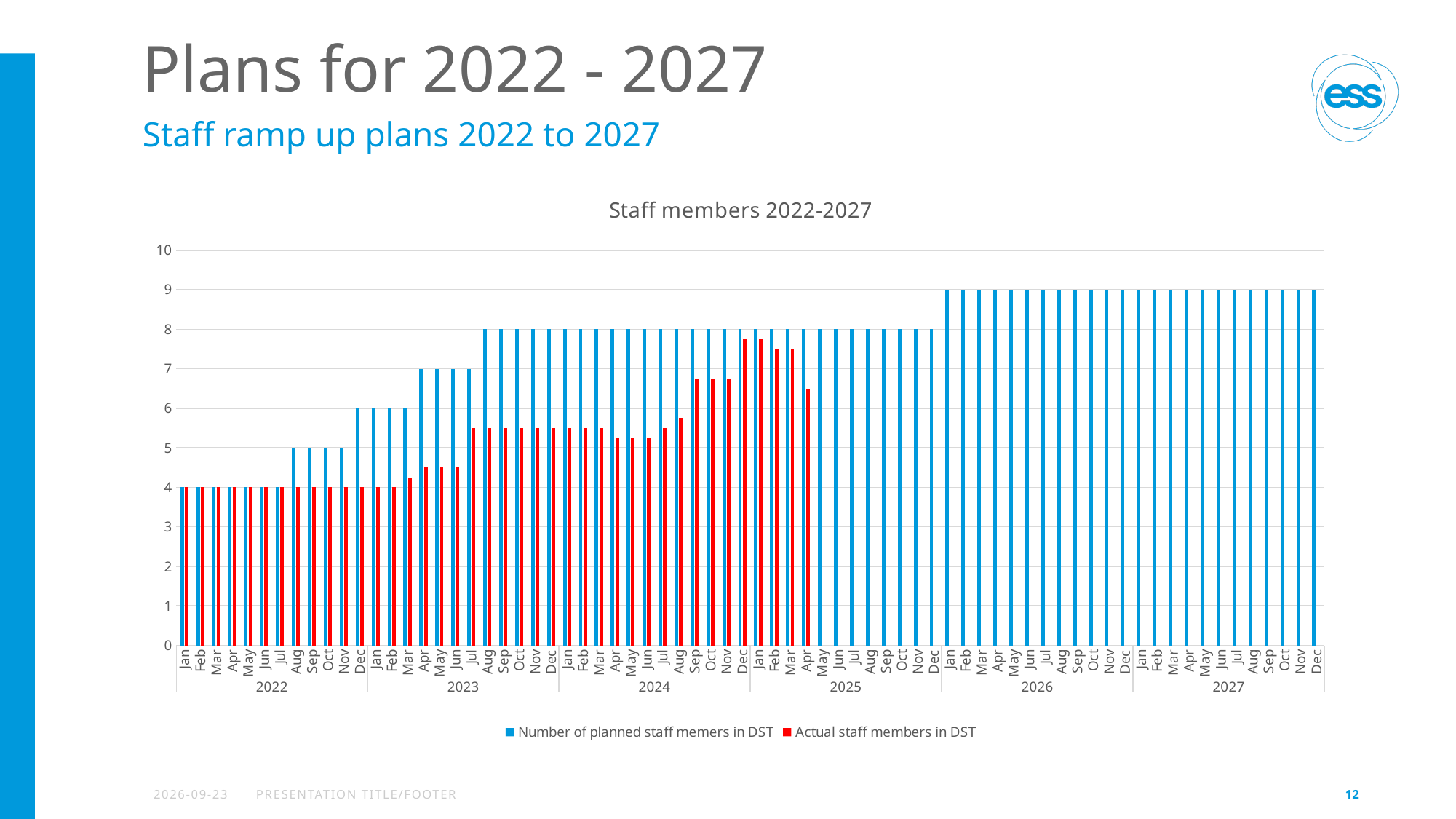
What is the number of planned staff members in DST for Aug 2023? 8 What is the number of planned staff members in DST for Jan 2022? 4 Do the planned staff member values rise or fall from 2022 to 2027? rise What is the number of planned staff members in DST for Jan 2023? 6 How many series does the legend list? 2 What is the title of the chart? Staff members 2022-2027 Is the value for actual staff members in DST in Apr 2025 greater or less than 7? less Is the value for actual staff members in DST in Jan 2025 greater or less than 7? greater What is the number of planned staff members in DST for Dec 2027? 9 What is the highest value reached by the planned staff members series? 9 What kind of chart is shown on the slide? bar chart In Apr 2025, which is larger: the planned staff members or the actual staff members? planned staff members